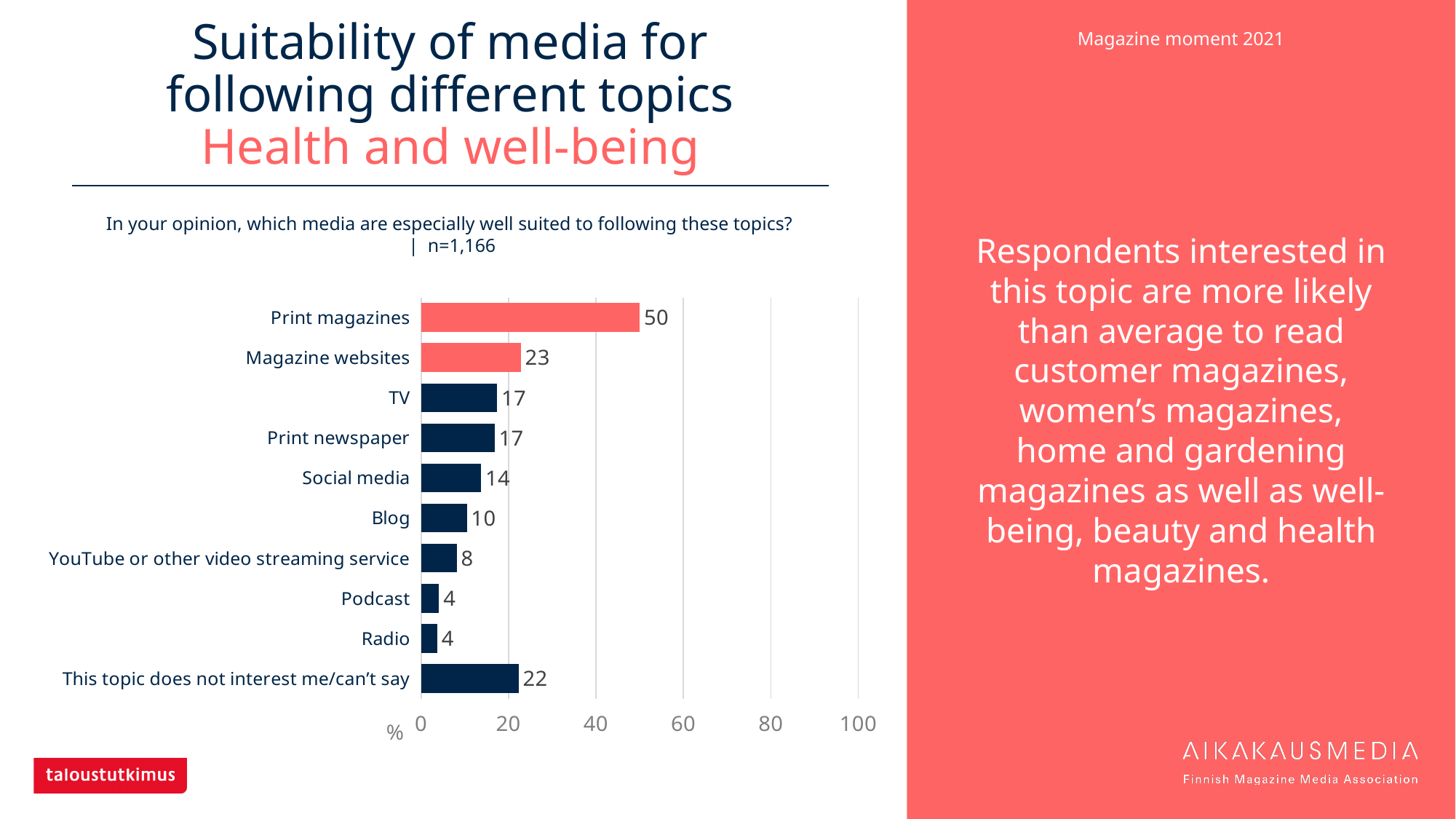
What is the difference between the values for Print magazines and Magazine websites? 27 What kind of chart is shown on the slide? bar chart Which is larger, the value for Blog or the value for YouTube or other video streaming service? Blog What is the value for Social media? 14 Is the value for Print magazines greater or less than 40? greater What is the value for 'This topic does not interest me/can't say'? 22 What is the value for Magazine websites? 23 What is the difference between the values for TV and Podcast? 13 What is the value for Print magazines? 50 How many categories are shown in the chart? 10 What is the sample size (n) stated above the chart? n=1,166 Which media category has the highest value? Print magazines